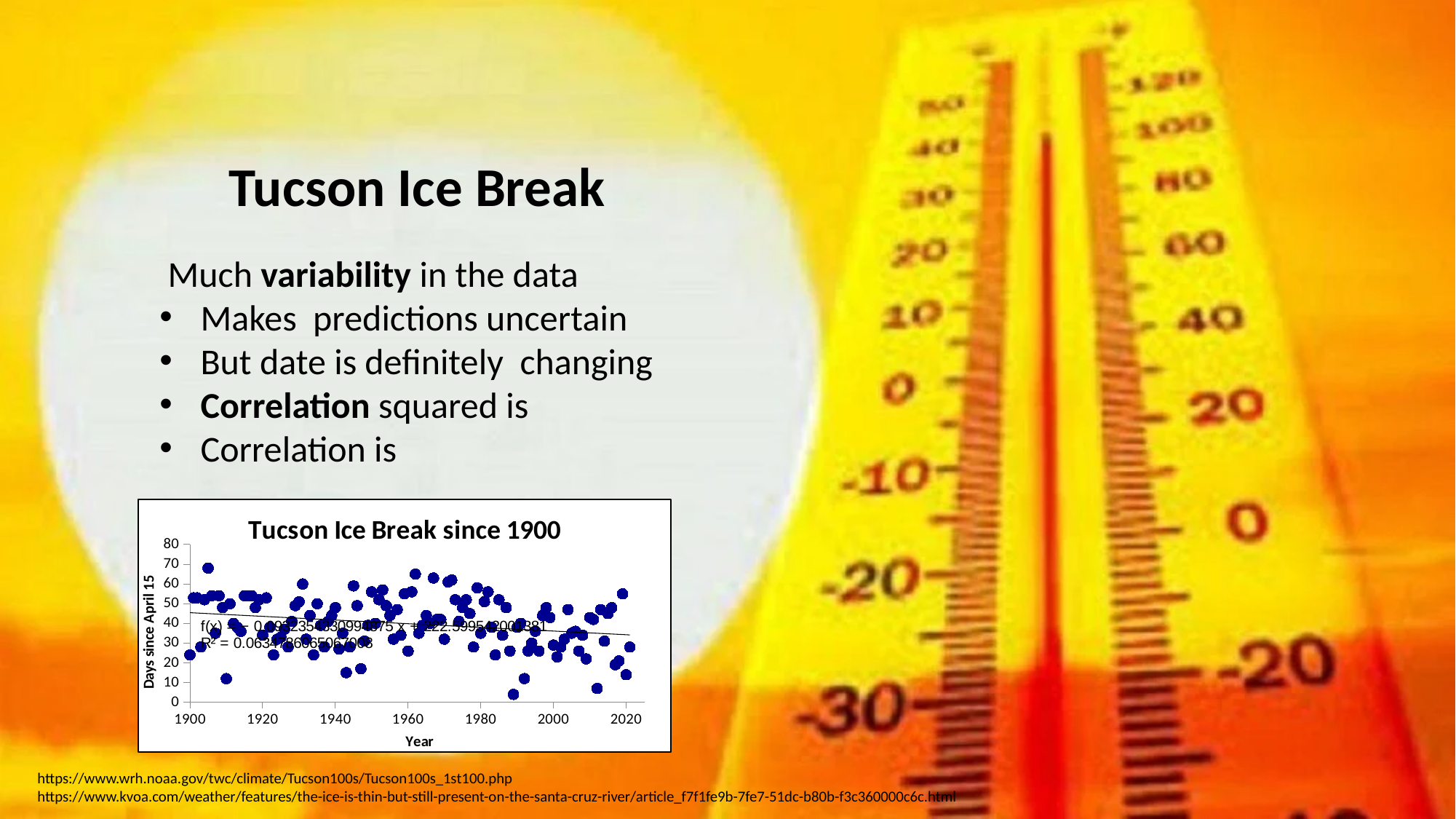
What is the title of the chart on the slide? Tucson Ice Break since 1900 What is the label of the vertical axis of the chart? Days since April 15 What kind of chart is shown on the slide? scatter chart Do the values in the chart generally rise or fall as the year increases, according to the fitted trend line? fall Is the highest point in the chart greater or less than 60 days since April 15? greater Is the lowest point in the chart greater or less than 10 days since April 15? less Is the trend line value at 1900 greater or less than 40 days since April 15? greater What is the first year shown on the x axis of the chart? 1900 What is the maximum value shown on the y axis of the chart? 80 What is the last year tick shown on the x axis of the chart? 2020